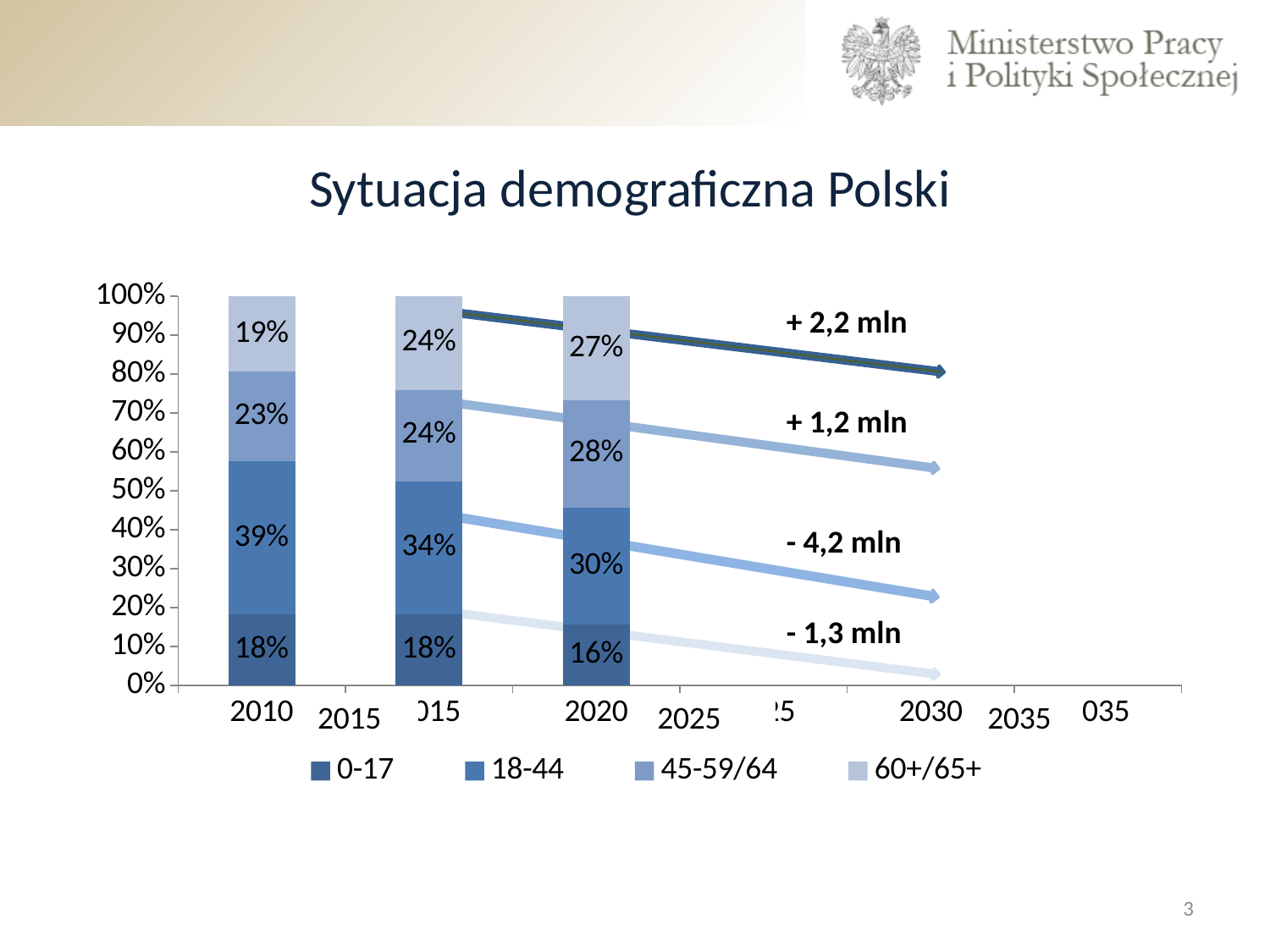
What is the share of the 60+/65+ group in the 2020 bar? 27% Does the share of the 60+/65+ group rise or fall from 2010 to 2020? rise How many series does the legend list? 4 By how many percentage points does the 18-44 share fall from 2010 to 2020? 9 percentage points What is the share of the 0-17 group in the 2020 bar? 16% Which is larger in the 2020 bar: the 45-59/64 share or the 60+/65+ share? 45-59/64 Which age group has the smallest share in the 2020 bar? 0-17 What is the share of the 45-59/64 group in the 2010 bar? 23% What is the title of the chart on the slide? Sytuacja demograficzna Polski Which age group has the largest share in the 2010 bar? 18-44 What kind of chart is shown on the slide? stacked bar chart What is the share of the 18-44 group in the 2010 bar? 39%